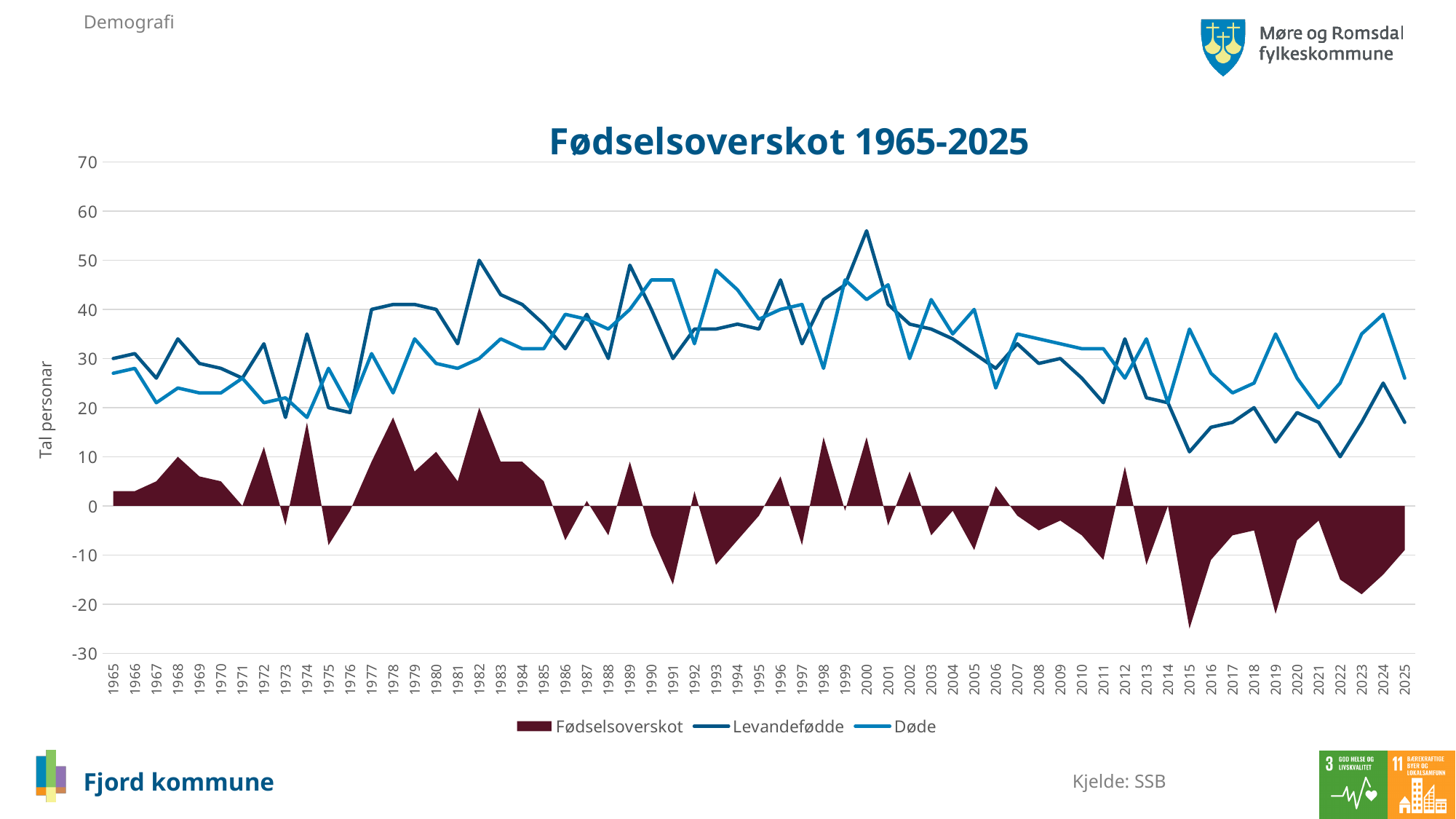
What is the title of the chart? Fødselsoverskot 1965-2025 Is the value for Døde in 2015 greater or less than 30? greater In 2015, which series has the larger value, Levandefødde or Døde? Døde Does the Levandefødde series generally rise or fall from 2000 to 2025? fall In 1982, which series has the larger value, Levandefødde or Døde? Levandefødde What is the label on the vertical axis of the chart? Tal personar Is the value for Levandefødde in 2000 greater or less than 50? greater Is the value for Fødselsoverskot in 2015 greater or less than -20? less How many years are plotted along the x axis of the chart? 61 How many series does the chart legend list? 3 In which year does the Levandefødde series reach its highest value? 2000